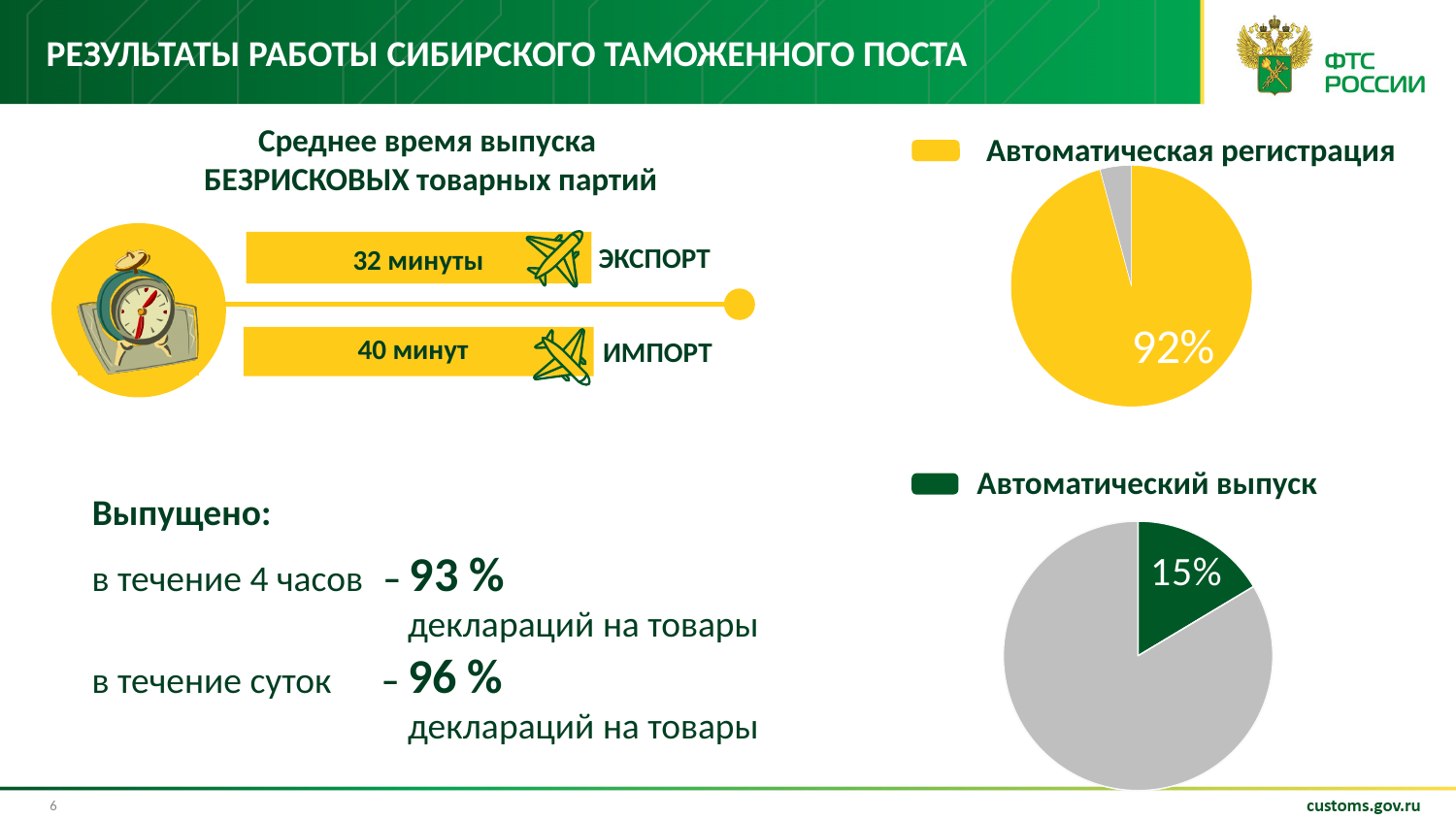
In the "Автоматическая регистрация" pie chart, what share is shown for the yellow slice? 92% In the bar graphic for average release time of risk-free consignments, what value is shown for ЭКСПОРТ? 32 минуты What kind of chart is the "Автоматическая регистрация" chart? pie chart How many slices does the "Автоматический выпуск" pie chart have? 2 What colour is the labelled slice in the "Автоматический выпуск" pie chart? green In the "Автоматический выпуск" pie chart, what share is shown for the green slice? 15% What colour is the legend marker next to "Автоматическая регистрация"? yellow What is the difference between the labelled share in the "Автоматическая регистрация" pie chart and the labelled share in the "Автоматический выпуск" pie chart? 77 percentage points Which pie chart has the larger labelled slice, "Автоматическая регистрация" or "Автоматический выпуск"? Автоматическая регистрация How many slices does the "Автоматическая регистрация" pie chart have? 2 In the "Автоматический выпуск" pie chart, is the labelled green slice greater or less than 50%? less